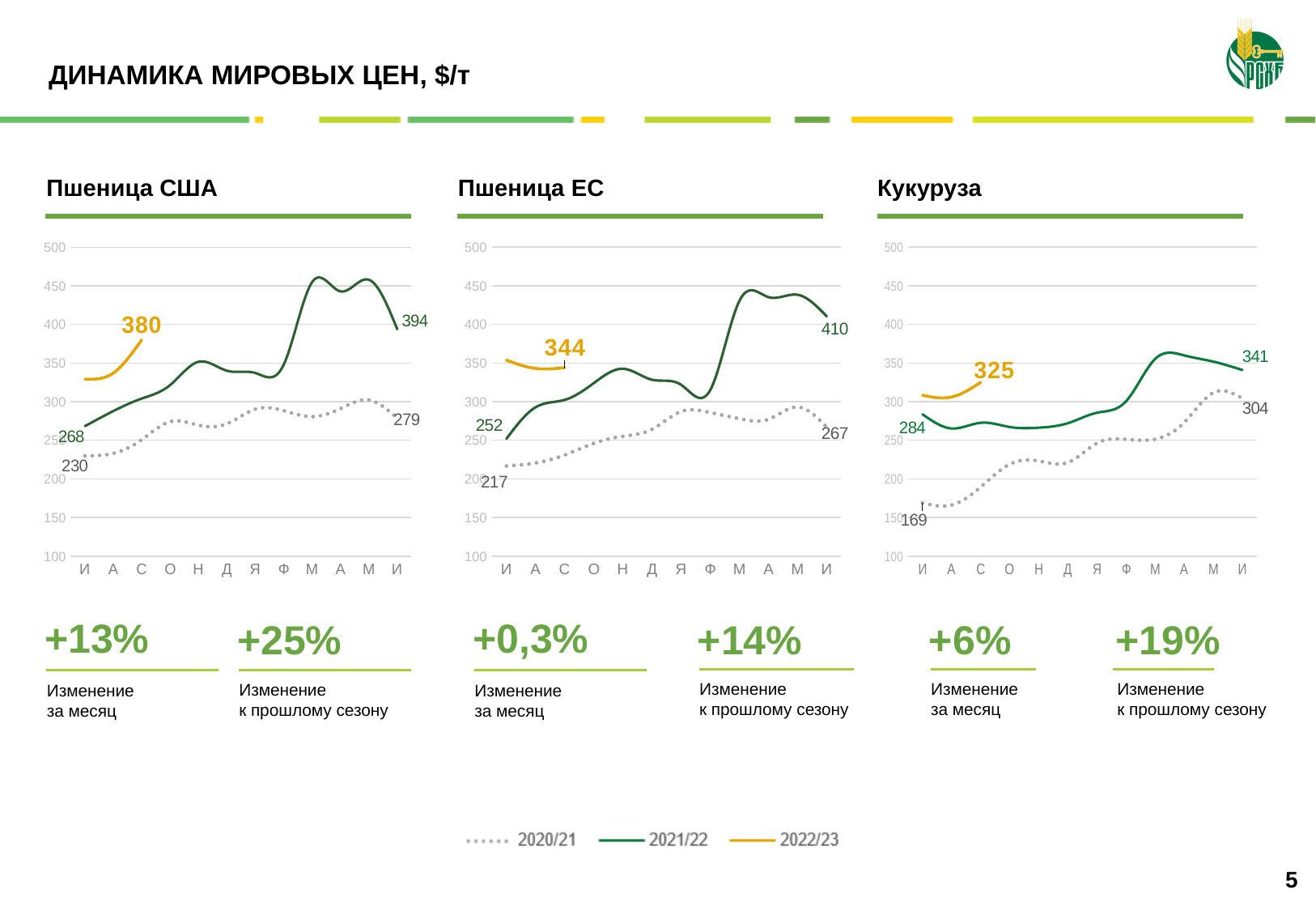
In the "Пшеница ЕС" chart, what is the first labelled value of the 2020/21 series? 217 In the "Кукуруза" chart, what is the first labelled value of the 2021/22 series? 284 In the "Кукуруза" chart, which is larger: the last labelled value of the 2021/22 series or the last labelled value of the 2020/21 series? 2021/22 (341) In the "Пшеница США" chart, what is the labelled value of the 2022/23 series? 380 In the "Пшеница США" chart, does the 2020/21 series overall rise or fall from its first labelled value (230) to its last labelled value (279)? rise How many month labels are shown on the x axis of the "Пшеница ЕС" chart? 12 In the "Пшеница ЕС" chart, what is the difference between the last labelled value of the 2021/22 series (410) and the last labelled value of the 2020/21 series (267)? 143 Which series in the legend is drawn with a dotted line? 2020/21 In the "Кукуруза" chart, is the first value of the 2020/21 series greater or less than 200? less What type of chart is used for the "Пшеница США" chart? line chart How many series does the legend at the bottom of the slide list? 3 In the "Пшеница США" chart, what is the last labelled value of the 2021/22 series? 394